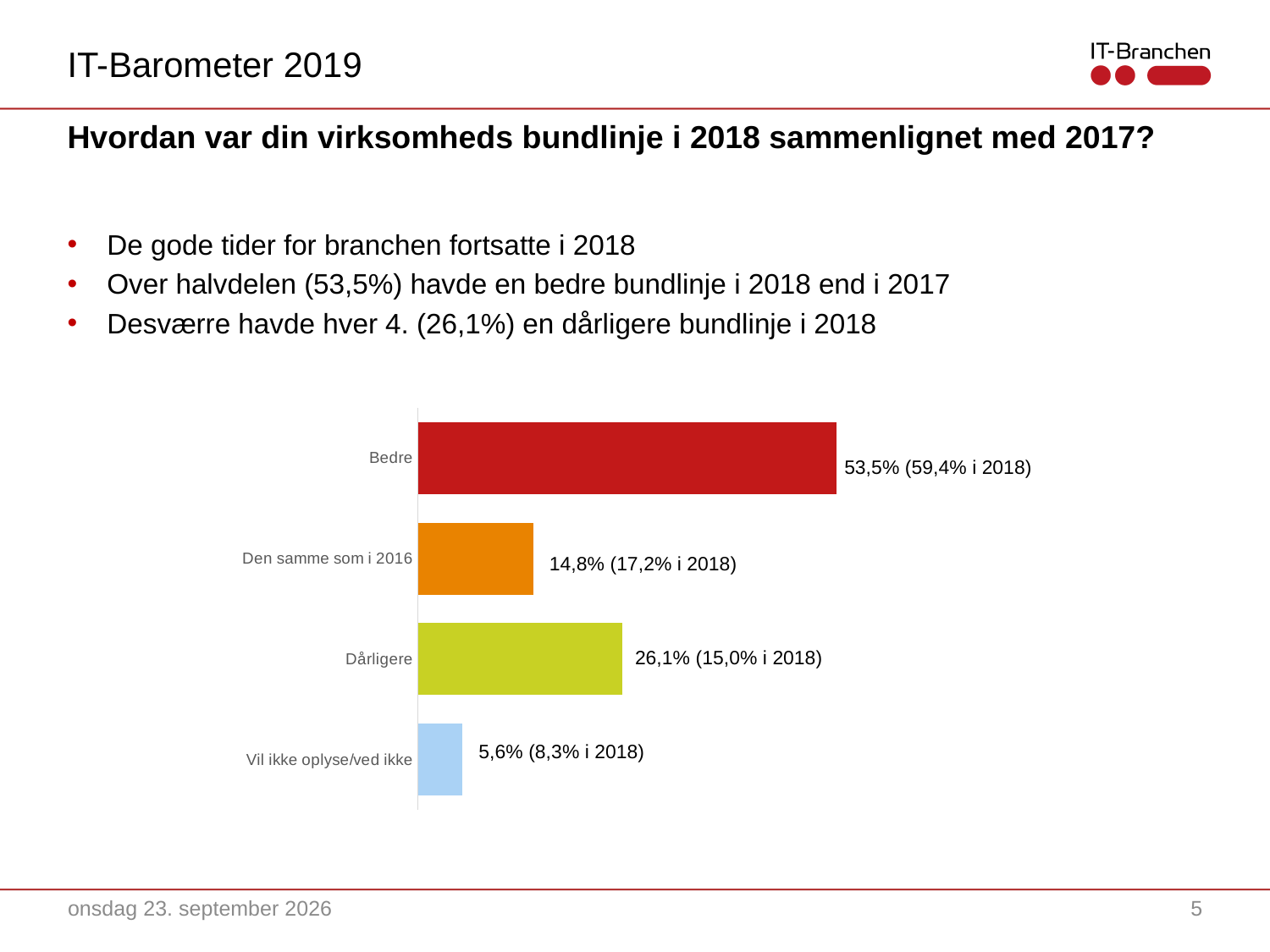
Which category has the lowest value in the bar chart? Vil ikke oplyse/ved ikke What is the value for "Vil ikke oplyse/ved ikke" in the bar chart? 5,6% What is the value for "Den samme som i 2016" in the bar chart? 14,8% What type of chart is shown on the slide? bar chart What is the value for "Bedre" in the bar chart? 53,5% How many categories does the bar chart show? 4 Which is larger, the value for "Dårligere" or the value for "Den samme som i 2016"? Dårligere What is the difference between the values for "Bedre" and "Dårligere"? 27,4% Which category has the highest value in the bar chart? Bedre According to the data label, what was the previous value shown in parentheses for "Bedre"? 59,4% What colour is the bar for "Dårligere"? yellow-green What is the value for "Dårligere" in the bar chart? 26,1%